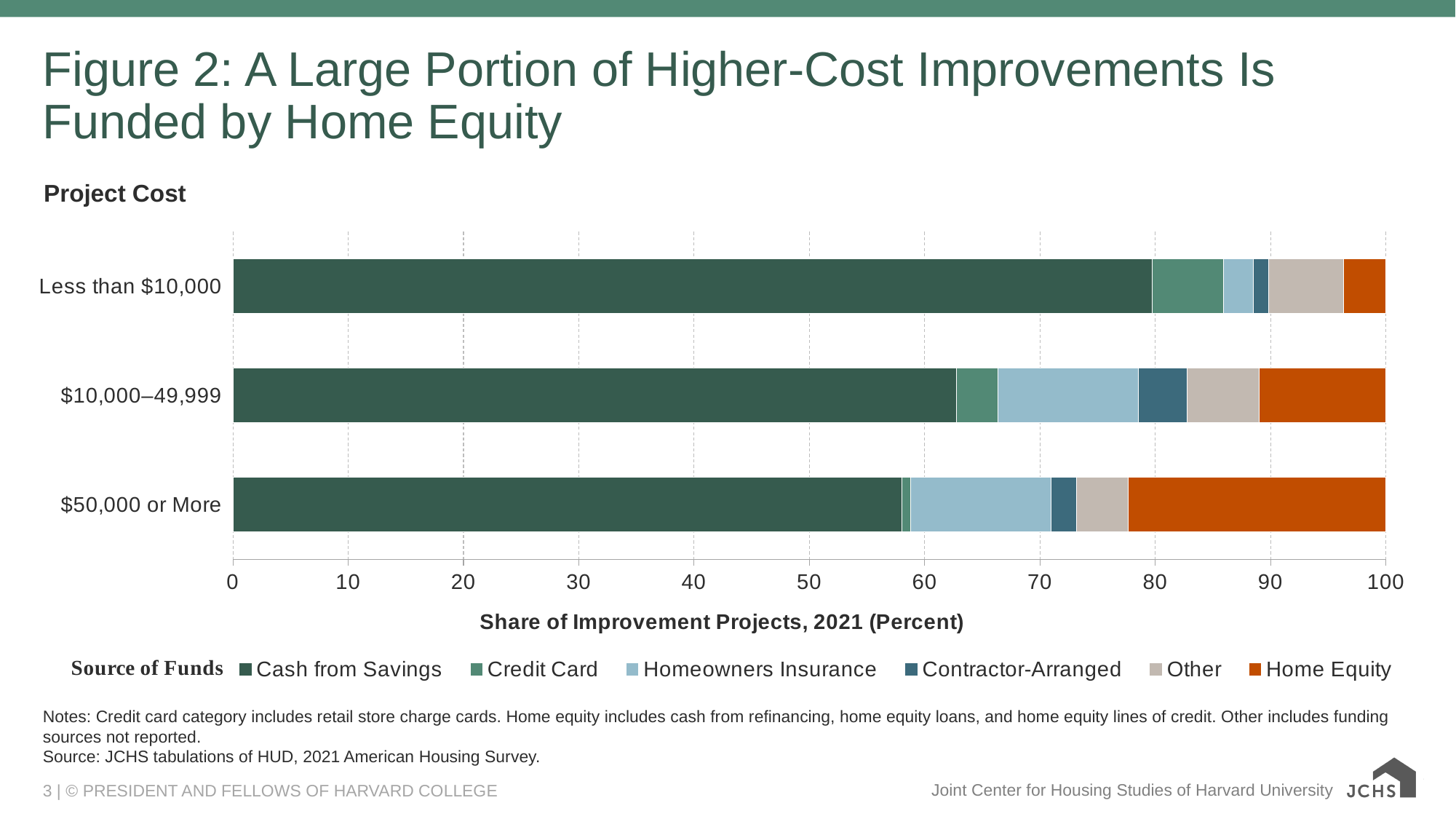
What kind of chart is shown on the slide? Stacked horizontal bar chart As project cost increases from Less than $10,000 to $50,000 or More, does the Home Equity share rise or fall? Rise Which project cost category has the largest Home Equity share? $50,000 or More Which project cost category has the smallest Home Equity share? Less than $10,000 Which project cost category has the largest Cash from Savings share? Less than $10,000 Which has a larger Cash from Savings share, $10,000–49,999 or $50,000 or More? $10,000–49,999 What is the label of the horizontal axis? Share of Improvement Projects, 2021 (Percent) Is the Cash from Savings share for Less than $10,000 projects greater or less than 70? greater How many project cost categories are shown on the chart? 3 Which project cost category has the smallest Homeowners Insurance share? Less than $10,000 Is the Cash from Savings share for $50,000 or More projects greater or less than 70? less How many sources of funds does the legend list? 6